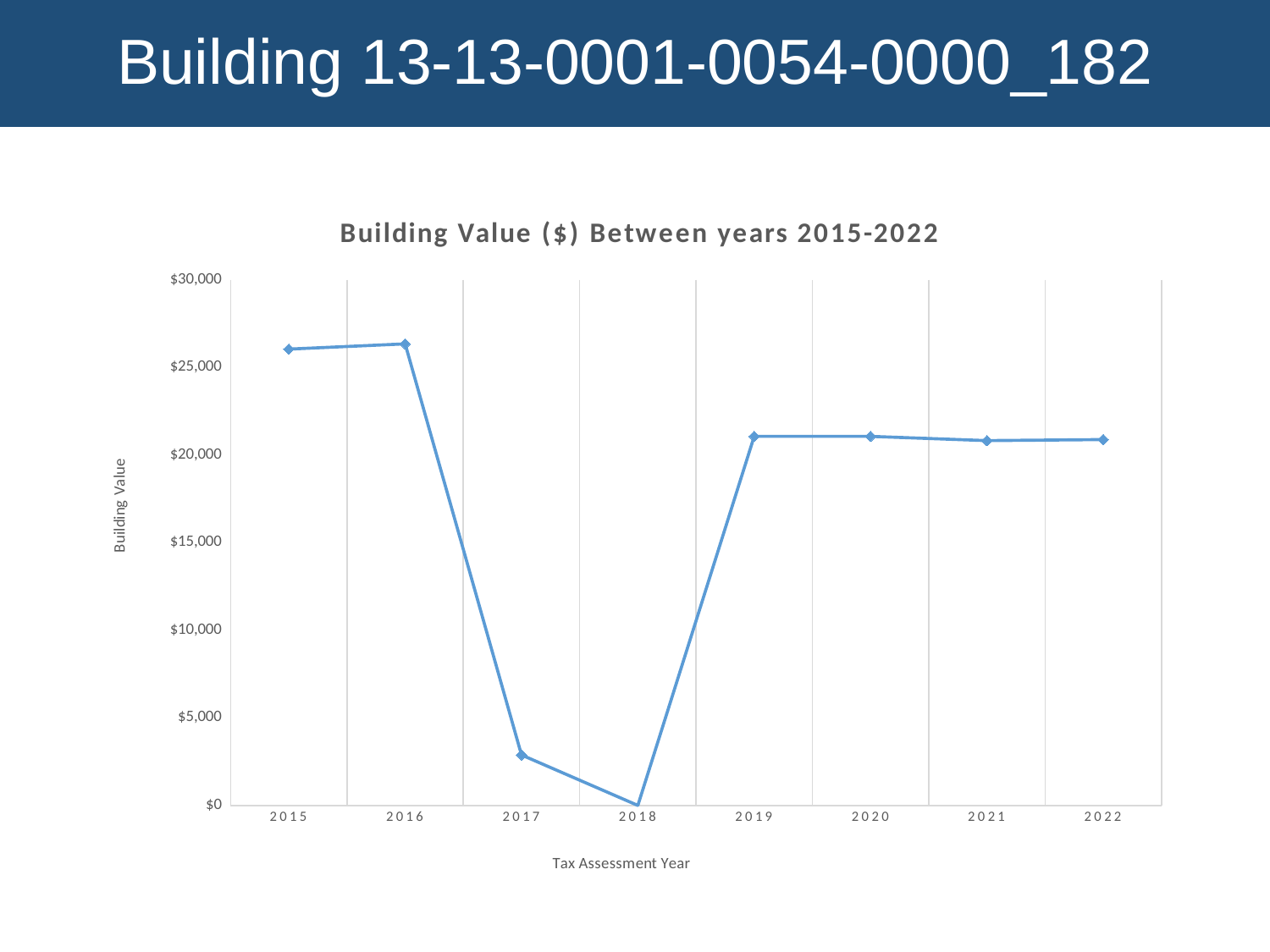
Is the building value for 2015 greater or less than $25,000? greater Is the building value for 2019 greater or less than $20,000? greater What is the building value for 2018? $0 Does the building value rise or fall from 2016 to 2018? fall What type of chart is shown on the slide? line chart Which year has the larger building value, 2016 or 2017? 2016 Which year has the lowest building value? 2018 Is the building value for 2017 greater or less than $5,000? less How many years are plotted on the chart? 8 Which year has the larger building value, 2015 or 2022? 2015 What is the title of the chart? Building Value ($) Between years 2015-2022 What is the label of the x axis? Tax Assessment Year